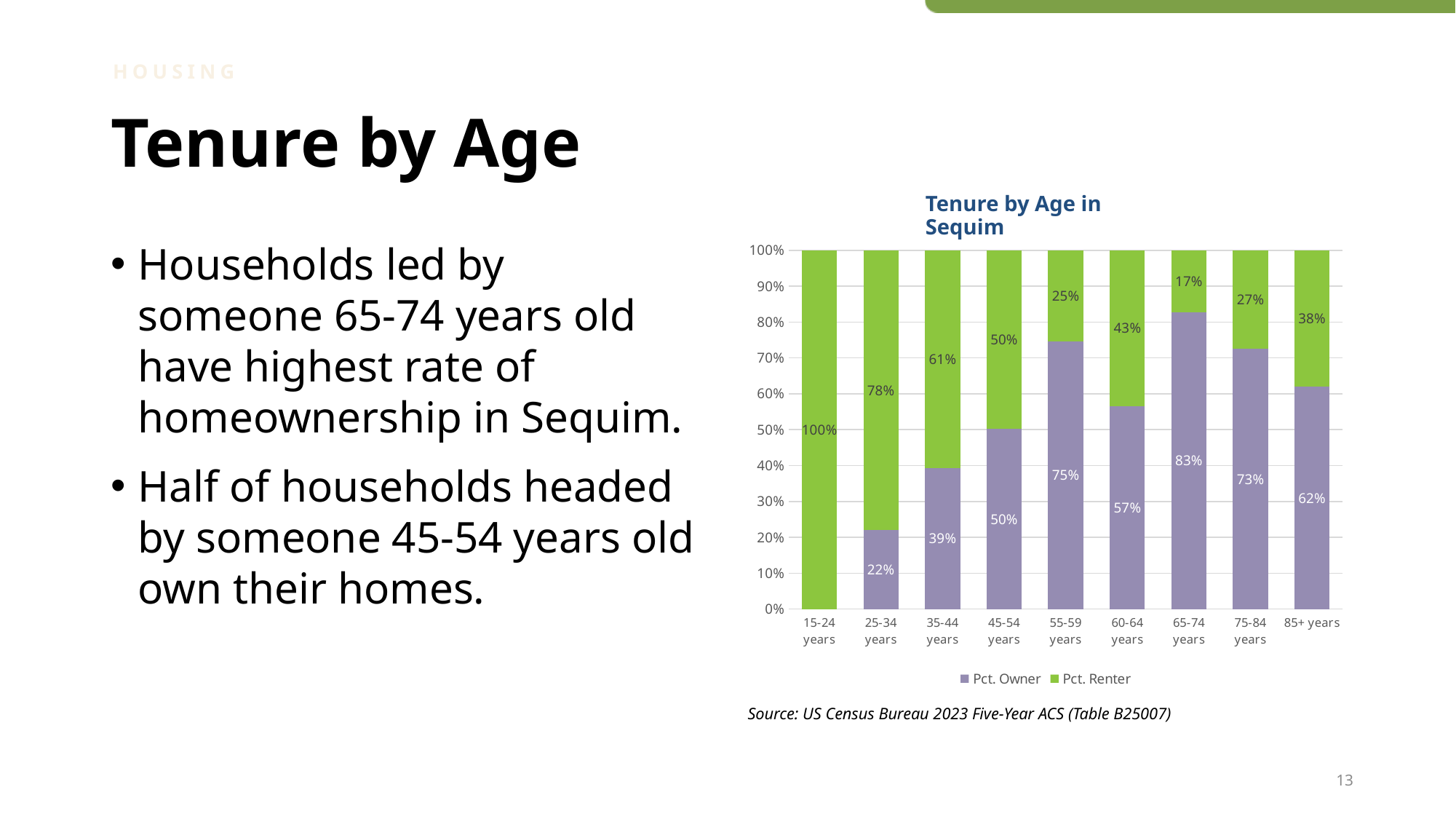
What kind of chart is shown on the slide? Stacked bar chart Which is larger: the Pct. Renter value for 60-64 years or for 75-84 years? 60-64 years What is the title of the chart? Tenure by Age in Sequim How many age groups are shown on the x axis of the chart? 9 What is the Pct. Renter value for the 25-34 years age group? 78% What is the Pct. Owner value for the 85+ years age group? 62% What is the Pct. Owner value for the 45-54 years age group? 50% What is the difference between the Pct. Owner values for the 65-74 years and 25-34 years age groups? 61% How many series does the chart's legend list? 2 What is the total of the stacked bar for the 55-59 years age group? 100% Which age group has the highest Pct. Owner value? 65-74 years Which age group has the lowest Pct. Renter value? 65-74 years